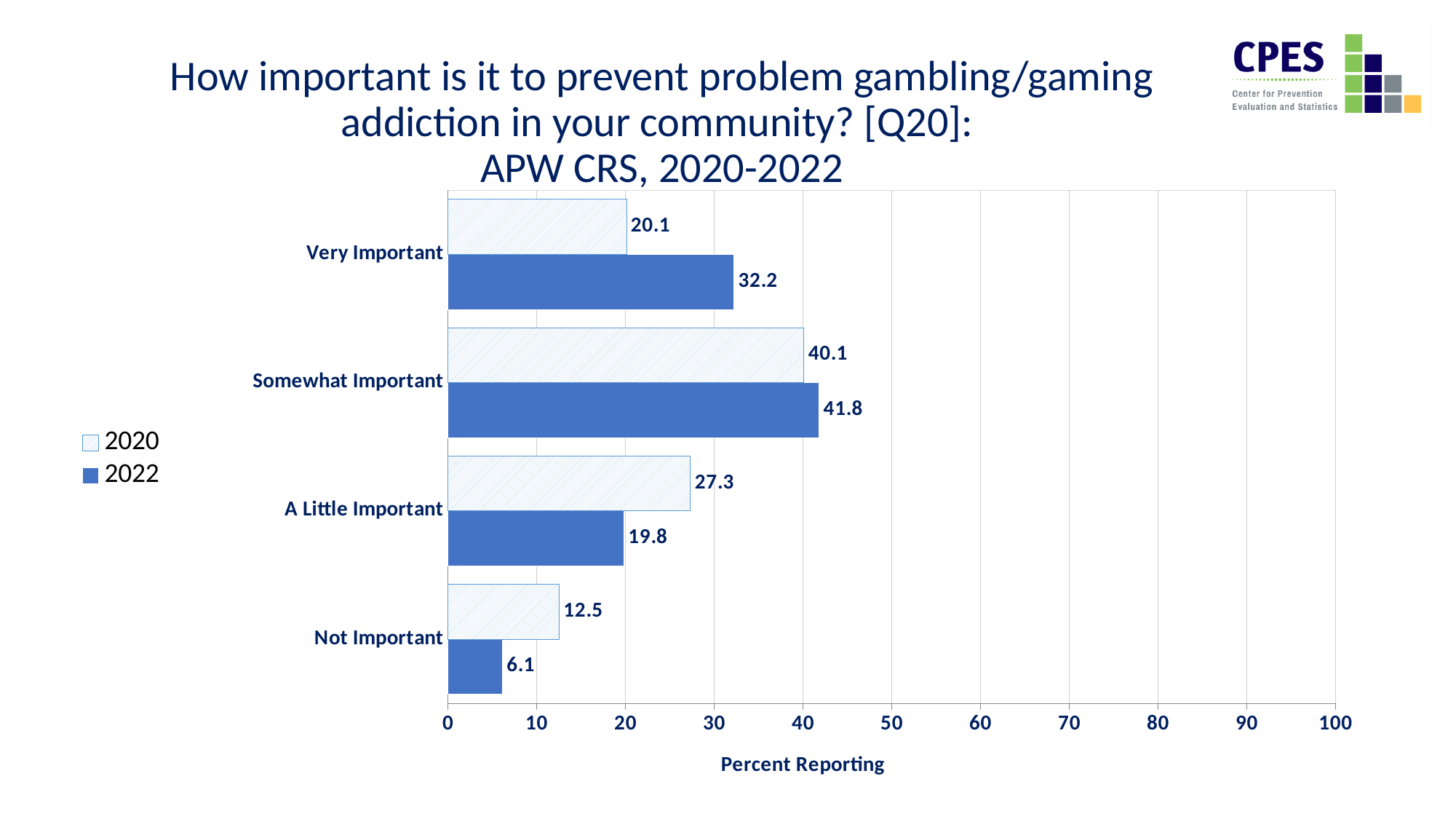
What percent reported 'Very Important' in 2022? 32.2 What percent reported 'Not Important' in 2020? 12.5 What kind of chart is shown on the slide? Bar chart What is the difference between the 2022 and 2020 values for 'Very Important'? 12.1 What percent reported 'A Little Important' in 2022? 19.8 Which category has the lowest value for 2020? Not Important How many response categories are shown on the chart? 4 How many series does the legend list? 2 What is the label of the horizontal axis? Percent Reporting Which is larger for 'A Little Important': the 2020 value or the 2022 value? 2020 Which category has the highest value for 2022? Somewhat Important What is the difference between the 2020 and 2022 values for 'Not Important'? 6.4